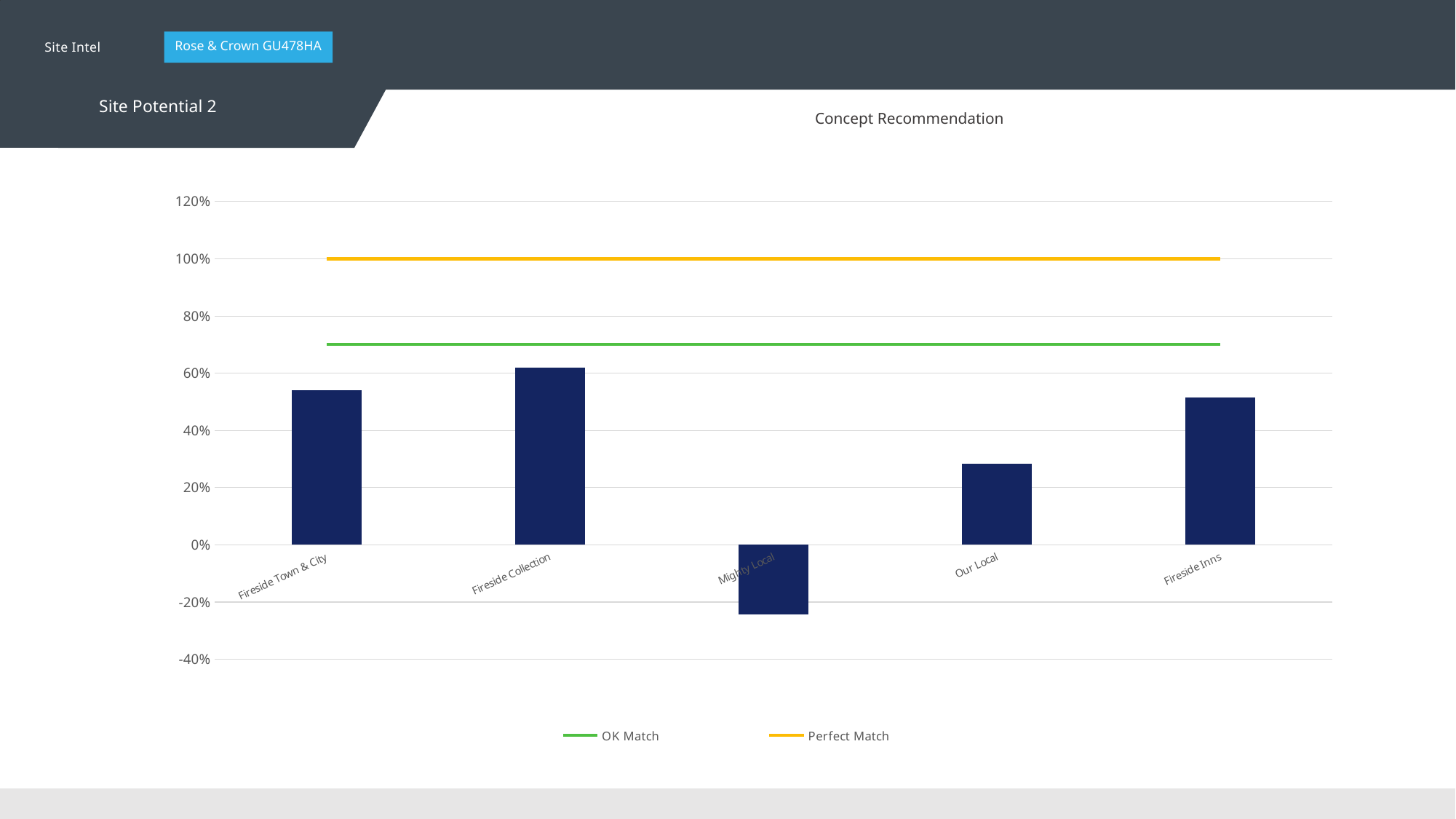
Which concept has the lowest bar? Mighty Local How many series does the legend list? 2 What colour is the OK Match line in the legend? green Is the value for Fireside Town & City greater or less than 40%? greater At what level is the Perfect Match line drawn? 100% Which is larger, the value for Fireside Collection or the value for Our Local? Fireside Collection What kind of chart is used to show the concept values? bar chart What is the title of the chart? Concept Recommendation Is the value for Mighty Local greater or less than 0%? less How many concept categories are shown on the x axis? 5 Which concept has the highest bar? Fireside Collection Is the value for Our Local greater or less than 40%? less